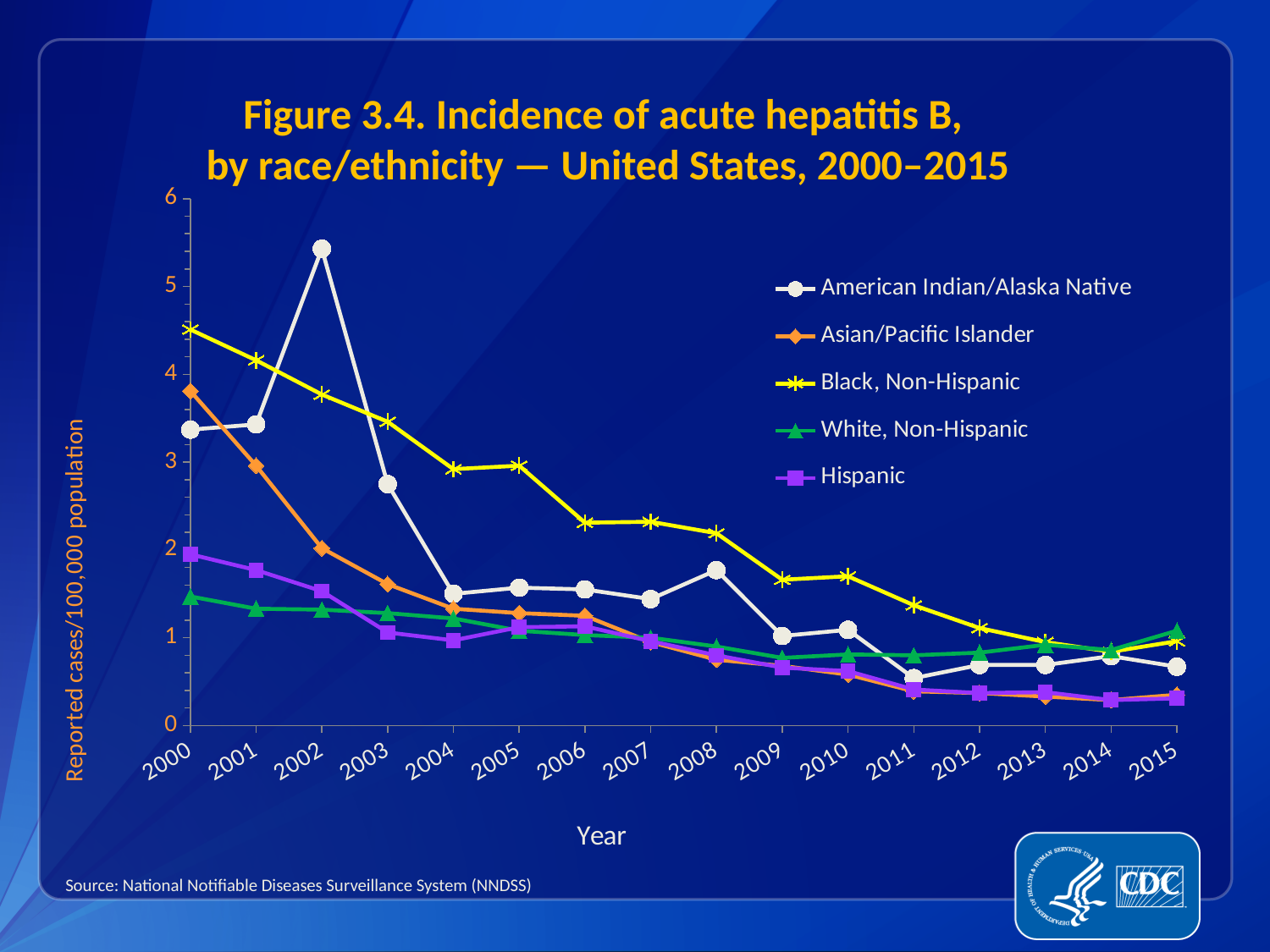
Does the Black, Non-Hispanic series generally rise or fall from 2000 to 2015? fall Which series has the highest value in 2000? Black, Non-Hispanic What is the label on the y axis? Reported cases/100,000 population How many years are plotted along the x axis? 16 Is the value for Black, Non-Hispanic in 2000 greater or less than 4? greater Which series has the lowest value in 2000? White, Non-Hispanic Is the value for American Indian/Alaska Native in 2002 greater or less than 5? greater In 2002, which is larger: the American Indian/Alaska Native value or the Black, Non-Hispanic value? American Indian/Alaska Native Is the value for Hispanic in 2015 greater or less than 1? less How many series does the legend list? 5 In which year does the American Indian/Alaska Native series reach its peak? 2002 What kind of chart is shown on the slide? line chart